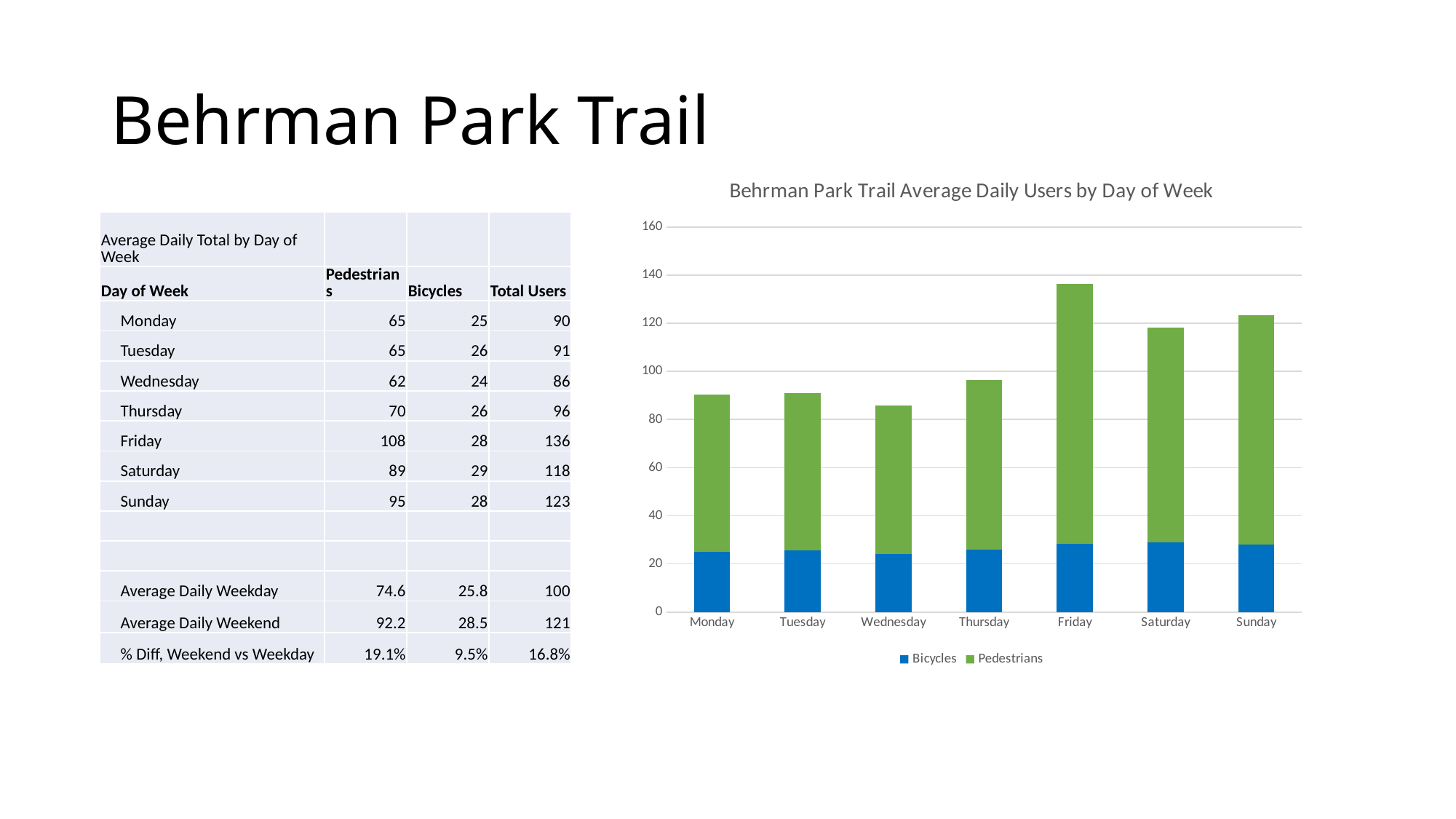
Is the total bar for Wednesday greater or less than 100? less Is the total bar for Friday greater or less than 120? greater What is the total of the stacked bar for Sunday, as given on the slide? 123 How many days of the week are plotted on the x axis of the chart? 7 How many series does the chart legend list? 2 According to the slide, what is the average daily number of pedestrians on Friday? 108 According to the slide, what is the average daily number of bicycles on Saturday? 29 What kind of chart is shown on the slide? stacked bar chart Which day has the lowest total bar in the chart? Wednesday Is the total bar for Saturday greater or less than Sunday's? less Which day has the highest total bar in the chart? Friday What is the title of the chart? Behrman Park Trail Average Daily Users by Day of Week